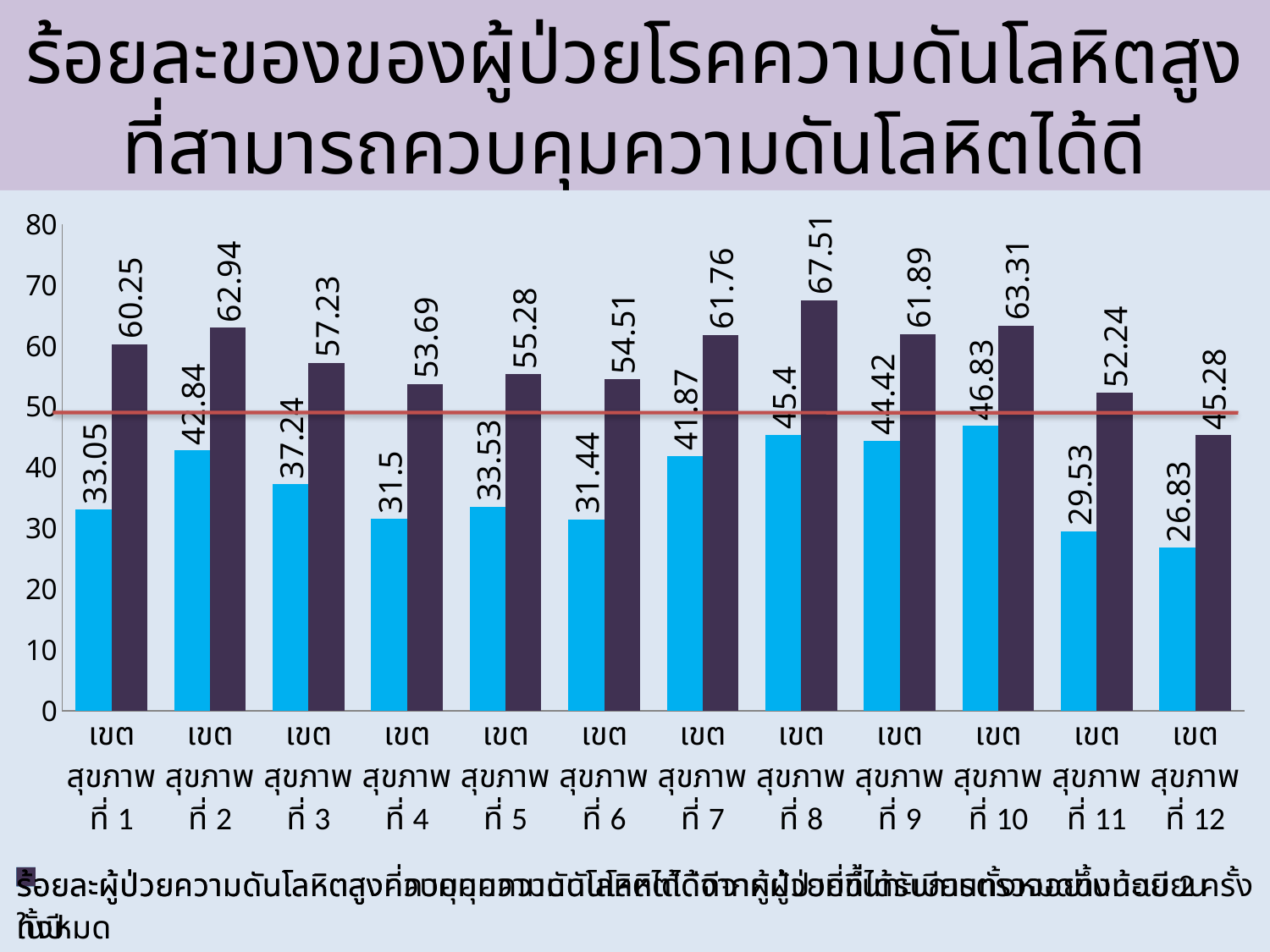
Which has the larger light blue value, เขตสุขภาพที่ 2 or เขตสุขภาพที่ 10? เขตสุขภาพที่ 10 What is the value of the light blue bar for เขตสุขภาพที่ 8? 45.4 Which category has the lowest light blue bar? เขตสุขภาพที่ 12 What is the value of the dark purple bar for เขตสุขภาพที่ 12? 45.28 Is the dark purple value for เขตสุขภาพที่ 12 greater or less than 50? less What is the difference between the dark purple values for เขตสุขภาพที่ 8 and เขตสุขภาพที่ 11? 15.27 What is the difference between the dark purple and light blue values for เขตสุขภาพที่ 1? 27.2 Which category has the highest light blue bar? เขตสุขภาพที่ 10 How many categories (เขตสุขภาพ) are shown on the x axis? 12 What kind of chart is shown on the slide? bar chart Which category has the highest dark purple bar? เขตสุขภาพที่ 8 How many data series are plotted as bars in the chart? 2